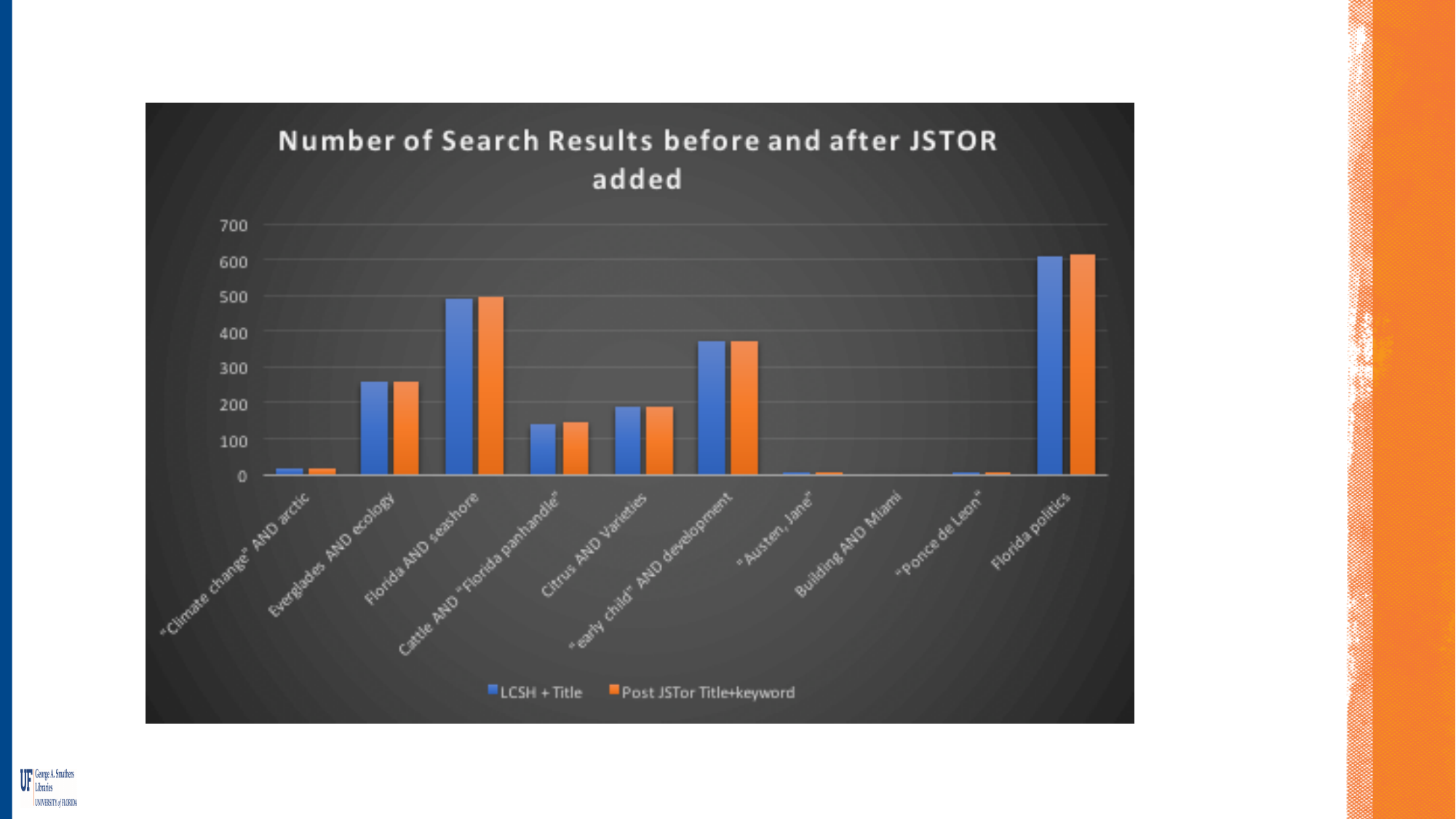
How many series does the legend list? 2 Is the Post JSTor Title+keyword value for Everglades AND ecology greater or less than 300? less What kind of chart is shown on the slide? bar chart Is the Post JSTor Title+keyword value for "Climate change" AND arctic greater or less than 100? less Is the LCSH + Title value for "early child" AND development greater or less than 300? greater How many search categories are shown on the x axis? 10 Which has more search results, Florida AND seashore or Everglades AND ecology? Florida AND seashore Which search category has the lowest number of results? Building AND Miami Which legend entry is shown in orange? Post JSTor Title+keyword What is the title of the chart? Number of Search Results before and after JSTOR added Which search category has the highest number of results? Florida politics